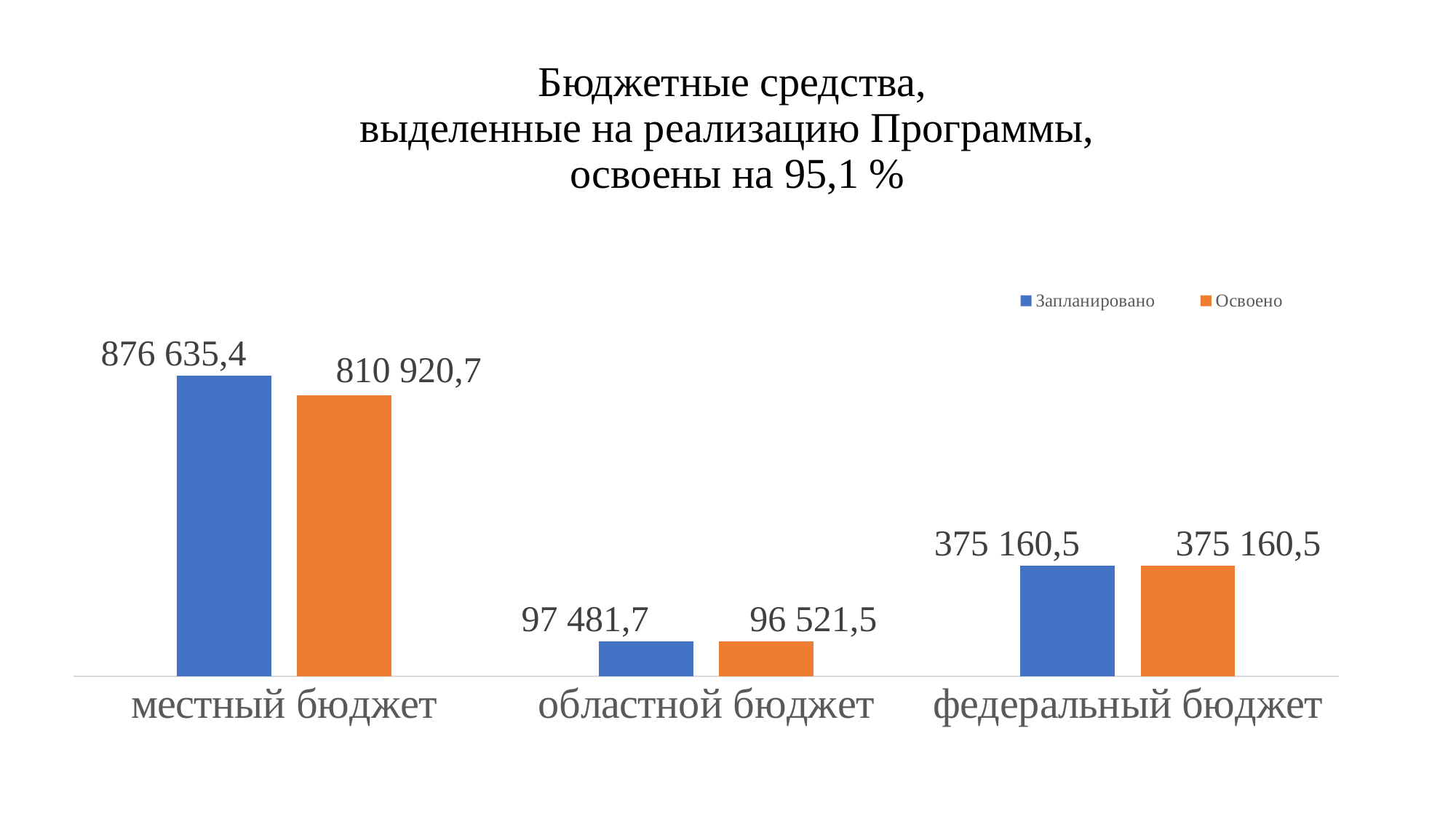
What is the difference between the Запланировано and Освоено values for местный бюджет? 65 714,7 What kind of chart is shown on the slide? bar chart What is the difference between the Запланировано and Освоено values for областной бюджет? 960,2 What is the Запланировано value for областной бюджет? 97 481,7 Which category has the lowest Освоено value? областной бюджет What is the Освоено value for местный бюджет? 810 920,7 How many series does the legend list? 2 Which is larger: the Освоено value for федеральный бюджет or the Освоено value for областной бюджет? федеральный бюджет Which category has the highest Запланировано value? местный бюджет What is the Запланировано value for местный бюджет? 876 635,4 How many categories are shown on the x axis? 3 What is the Освоено value for федеральный бюджет? 375 160,5